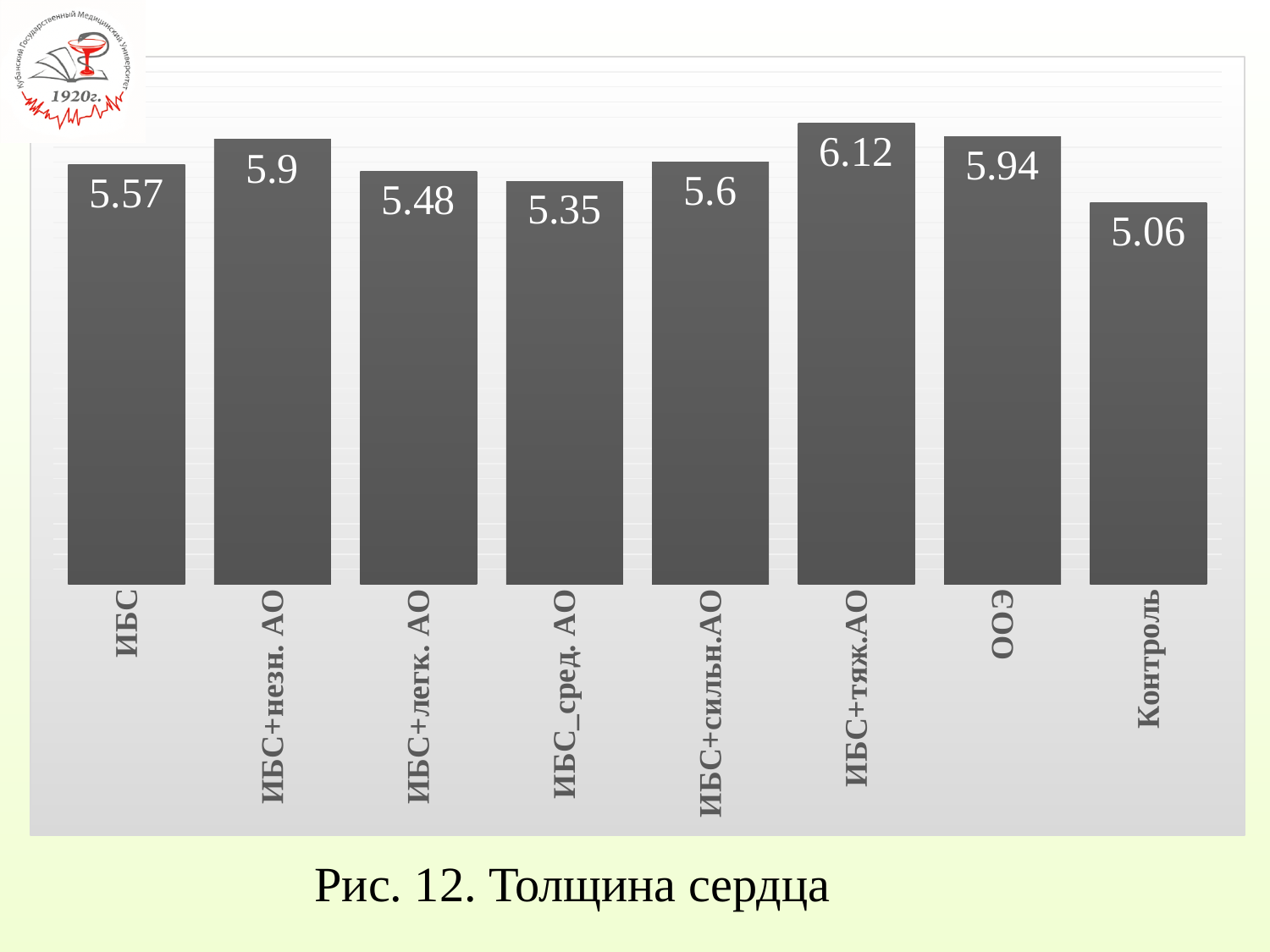
What is the difference between the values for ИБС+незн. АО and ИБС? 0.33 Which category has the lowest value? Контроль Which category has the highest value? ИБС+тяж.АО What is the value for Контроль? 5.06 What kind of chart is shown on the slide? bar chart What is the value for ИБС_сред. АО? 5.35 What is the value for ИБС+тяж.АО? 6.12 How many categories are shown in the chart? 8 Which is larger, the value for ИБС+сильн.АО or the value for ИБС+легк. АО? ИБС+сильн.АО What is the caption of the figure below the chart? Рис. 12. Толщина сердца What is the value for ООЭ? 5.94 What is the difference between the values for ИБС+тяж.АО and Контроль? 1.06